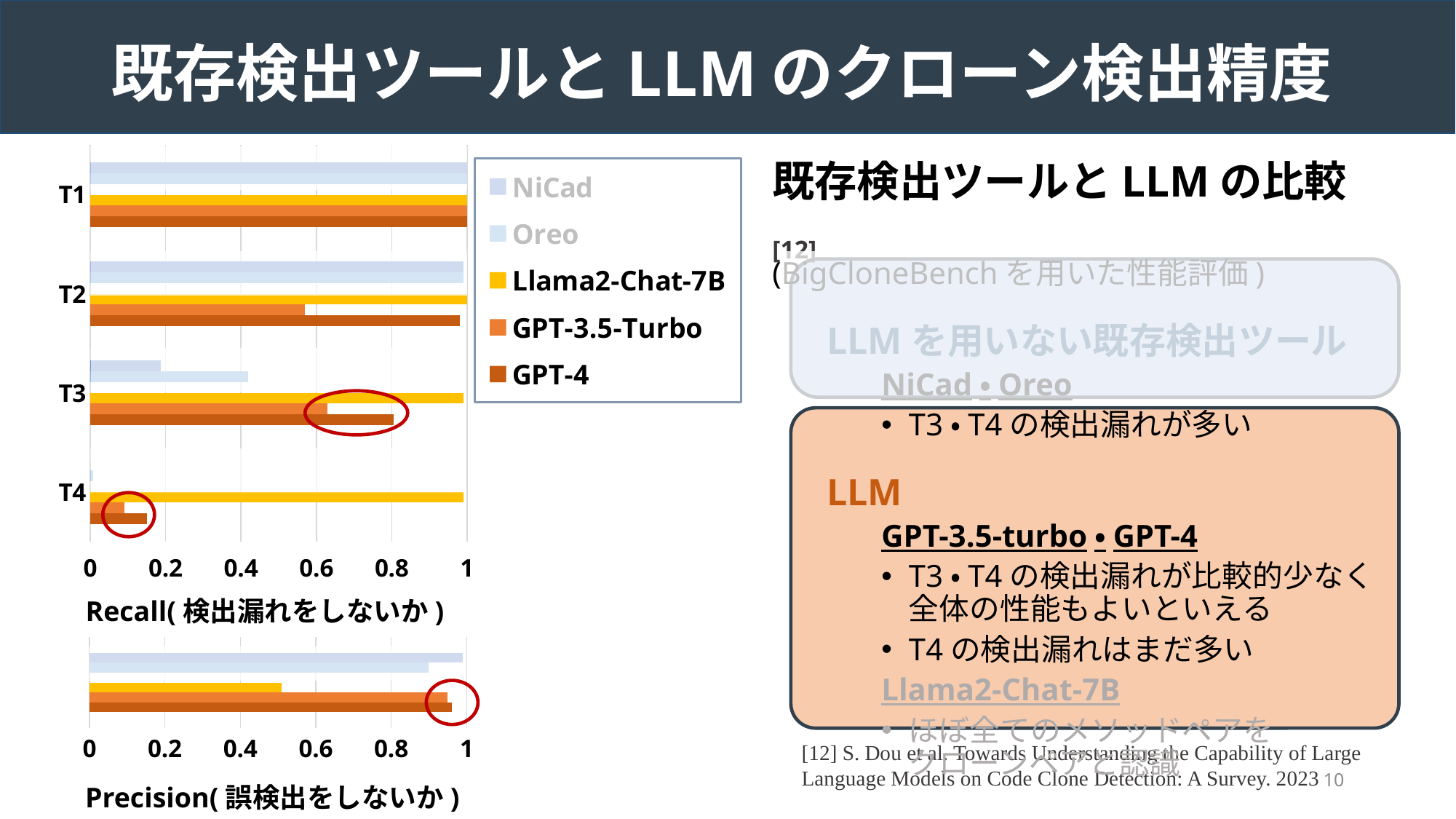
In the Precision chart, which series has the lowest value? Llama2-Chat-7B In the Recall chart at T2, which is larger: GPT-3.5-Turbo or GPT-4? GPT-4 In the Recall chart, is the value for GPT-4 at T4 greater or less than 0.2? less In the Recall chart, is the value for Llama2-Chat-7B at T3 greater or less than 0.8? greater In the Precision chart, is the value for NiCad greater or less than 0.8? greater What kind of chart is the Recall chart on the left of the slide? bar chart In the Recall chart, do the GPT-4 values rise or fall going from T1 to T4? fall In the Recall chart at T3, which is larger: NiCad or Oreo? Oreo How many series does the legend list for the charts? 5 How many categories (T1–T4) are shown on the Recall chart? 4